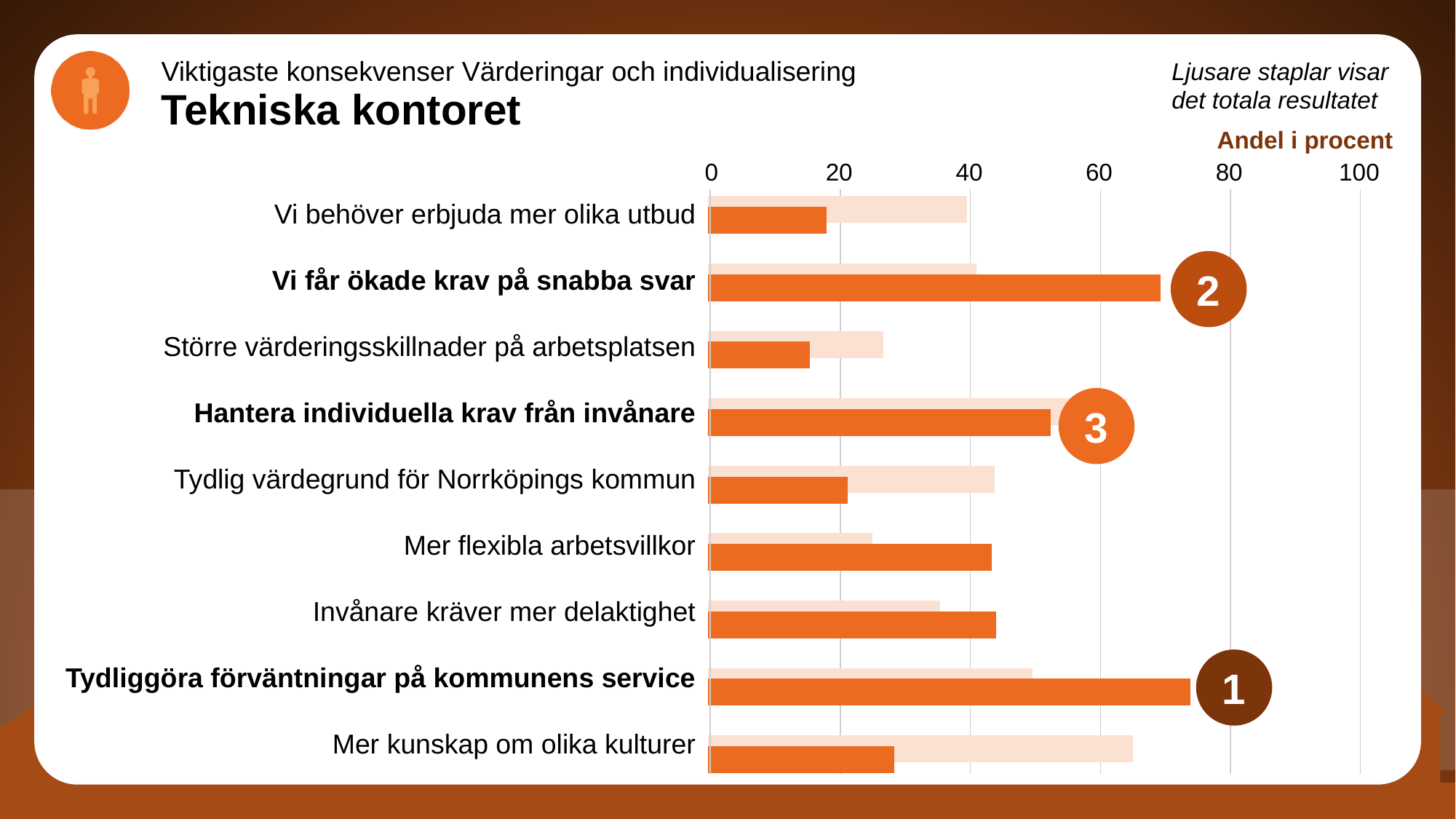
How many categories (consequences) are listed on the chart? 9 Is the dark orange bar for 'Mer kunskap om olika kulturer' greater or less than 40? less Which has the longer dark orange bar: 'Mer flexibla arbetsvillkor' or 'Mer kunskap om olika kulturer'? Mer flexibla arbetsvillkor According to the note on the slide, what do the lighter bars show? Det totala resultatet What is the label shown above the horizontal axis of the chart? Andel i procent Which category has the longest dark orange bar? Tydliggöra förväntningar på kommunens service For 'Mer kunskap om olika kulturer', which bar is longer: the dark orange bar or the lighter bar? The lighter bar Is the lighter bar for 'Mer kunskap om olika kulturer' greater or less than 60? greater Is the dark orange bar for 'Vi får ökade krav på snabba svar' greater or less than 60? greater What kind of chart is shown on the slide? Bar chart